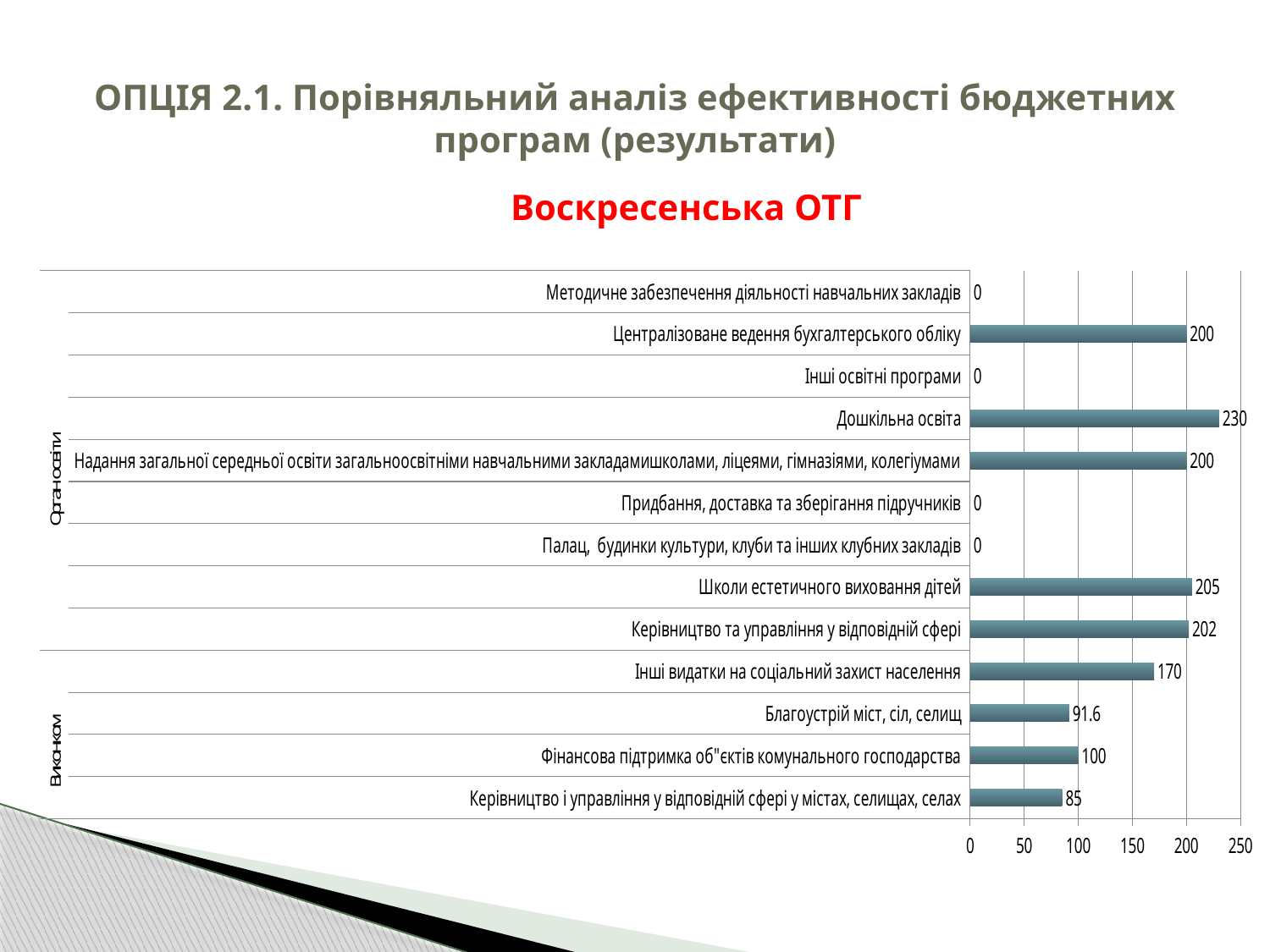
What kind of chart is shown on the slide? bar chart Which is larger: the value for Школи естетичного виховання дітей or the value for Керівництво та управління у відповідній сфері? Школи естетичного виховання дітей What is the value for Інші видатки на соціальний захист населення? 170 How many categories have a value of 0? 4 What is the value for Керівництво і управління у відповідній сфері у містах, селищах, селах? 85 How many categories are plotted in the chart? 13 Is the value for Інші видатки на соціальний захист населення greater or less than 150? greater Which category has the highest value? Дошкільна освіта What is the value for Дошкільна освіта? 230 What is the value for Благоустрій міст, сіл, селищ? 91.6 What is the difference between the values for Дошкільна освіта and Школи естетичного виховання дітей? 25 What is the difference between the values for Фінансова підтримка об"єктів комунального господарства and Благоустрій міст, сіл, селищ? 8.4